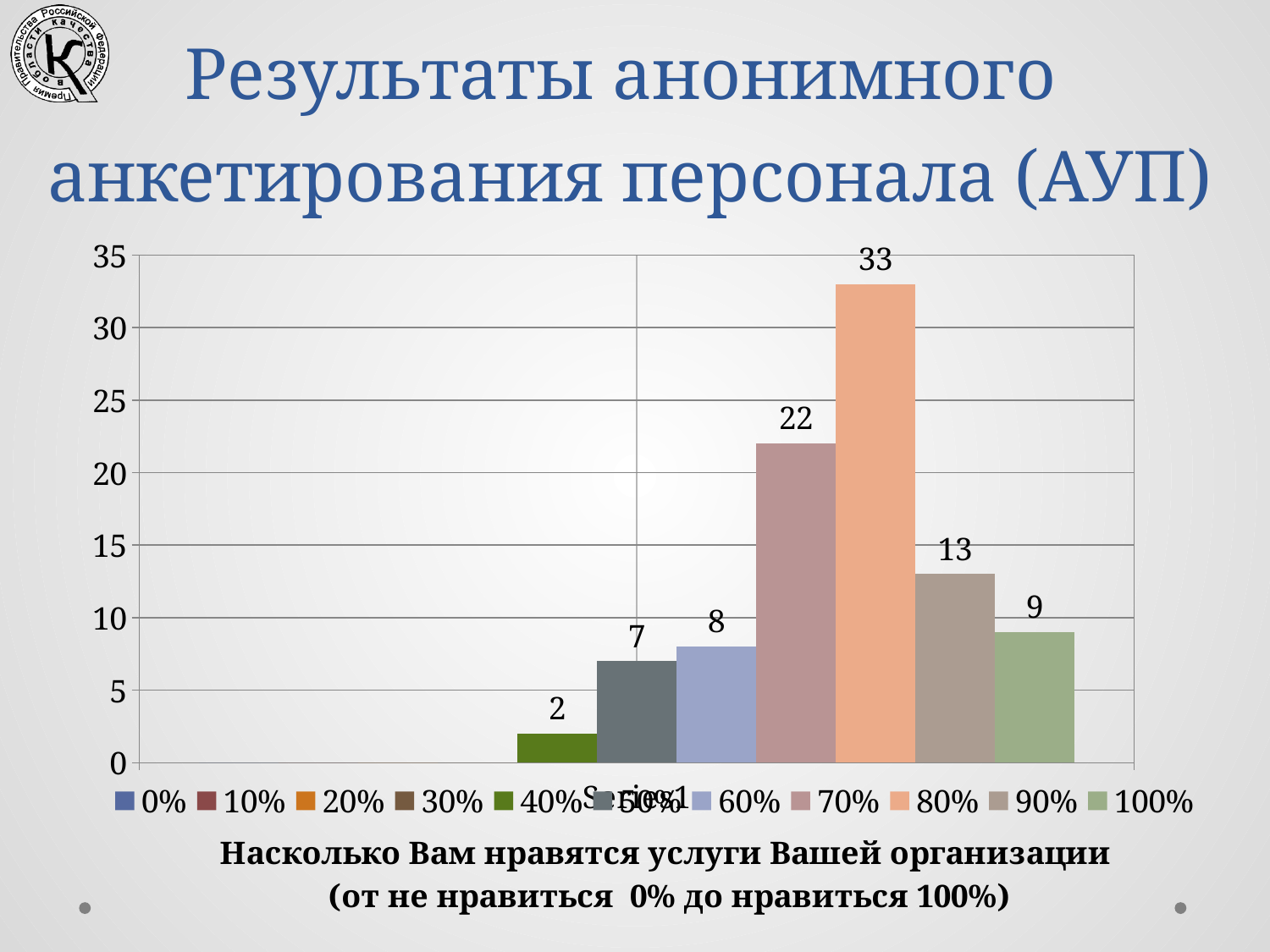
What kind of chart is shown on the slide? bar chart What is the difference between the values for 90% and 100%? 4 What value is shown for the 80% category? 33 What value is shown for the 70% category? 22 What is the difference between the values for 80% and 70%? 11 What is the colour of the bar for the 80% category? orange What value is shown for the 100% category? 9 Which category has the highest value? 80% How many entries does the legend list? 11 What value is shown for the 40% category? 2 Which is larger, the value for 50% or the value for 60%? 60% Is the value for 90% greater or less than 10? greater